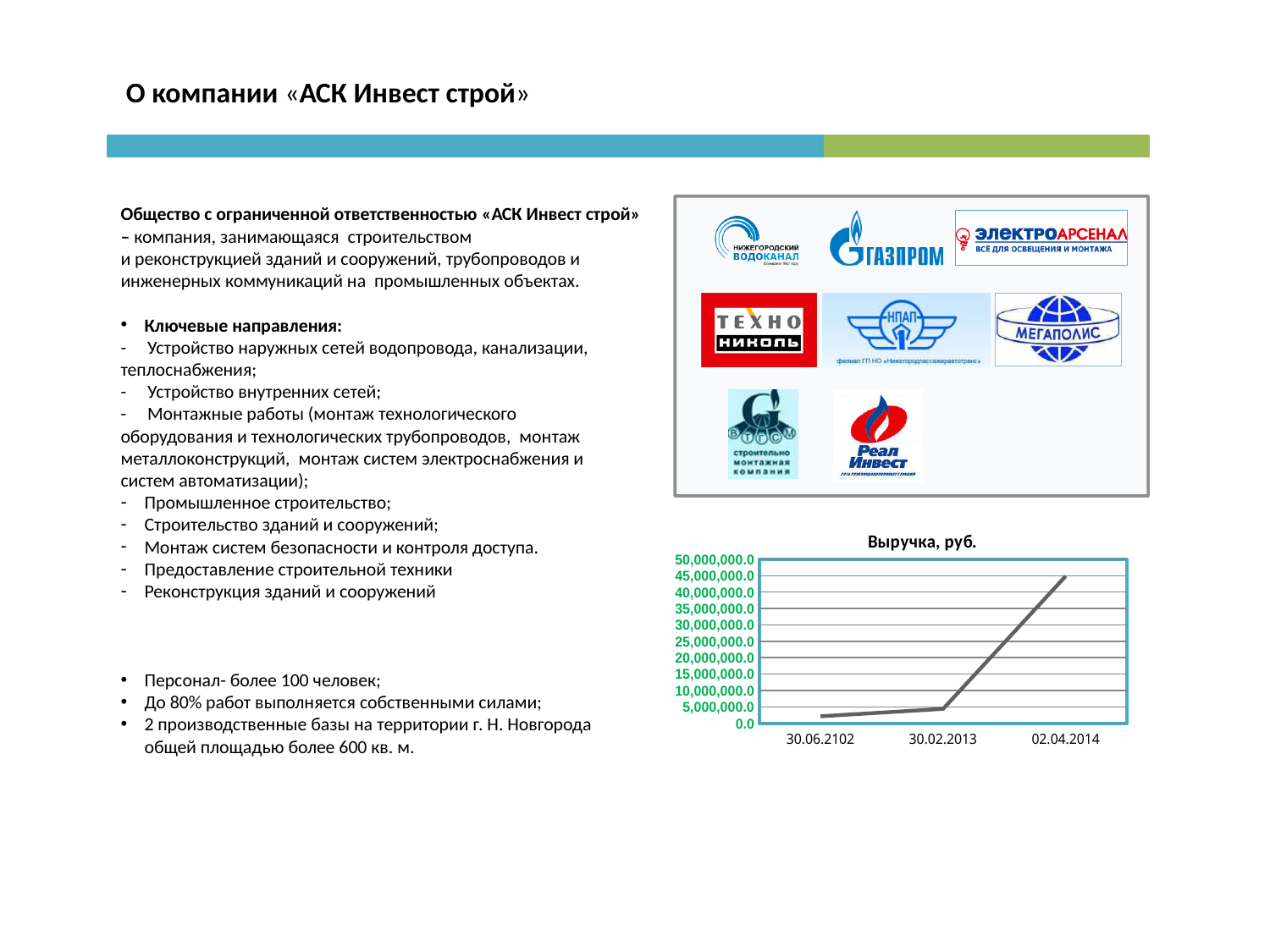
Which date has the highest value on the chart? 02.04.2014 What is the title of the chart? Выручка, руб. What kind of chart is shown on the slide? line chart What is the highest tick value shown on the y axis of the chart? 50,000,000.0 How many data points are plotted on the chart? 3 Is the value for 02.04.2014 greater or less than 40,000,000.0? greater Do the values rise or fall along the x axis from 30.06.2102 to 02.04.2014? rise Is the value for 30.06.2102 greater or less than 5,000,000.0? less What is the label of the first date on the x axis? 30.06.2102 Is the value for 30.02.2013 greater or less than 10,000,000.0? less Which date has the lowest value on the chart? 30.06.2102 Which is larger, the value for 02.04.2014 or the value for 30.02.2013? 02.04.2014